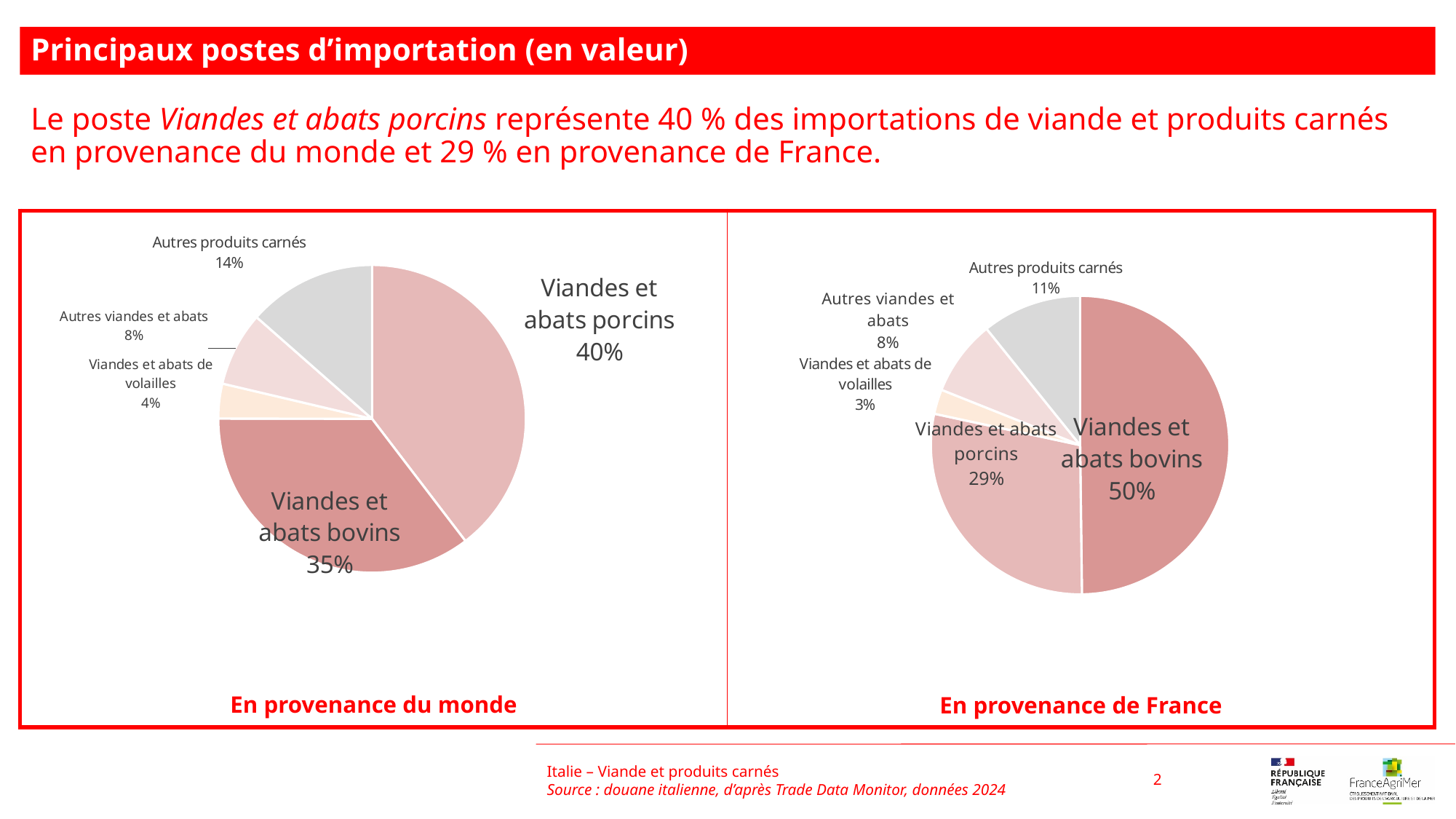
In the 'En provenance de France' pie chart, what share do Viandes et abats porcins represent? 29% What type of chart is used on the slide? Pie chart In the 'En provenance du monde' pie chart, what share do Viandes et abats de volailles represent? 4% In the 'En provenance de France' pie chart, what is the difference between the shares of Viandes et abats bovins and Viandes et abats porcins? 21 percentage points How many slices does the 'En provenance du monde' pie chart have? 5 In the 'En provenance du monde' pie chart, what is the difference between the shares of Viandes et abats porcins and Viandes et abats bovins? 5 percentage points In the 'En provenance du monde' pie chart, which category has the largest share? Viandes et abats porcins What is the title of the slide? Principaux postes d'importation (en valeur) In the 'En provenance de France' pie chart, which is larger: the share of Autres produits carnés or the share of Autres viandes et abats? Autres produits carnés In the 'En provenance de France' pie chart, what share do Viandes et abats bovins represent? 50% In the 'En provenance du monde' pie chart, what share do Viandes et abats porcins represent? 40% In the 'En provenance de France' pie chart, which category has the smallest share? Viandes et abats de volailles